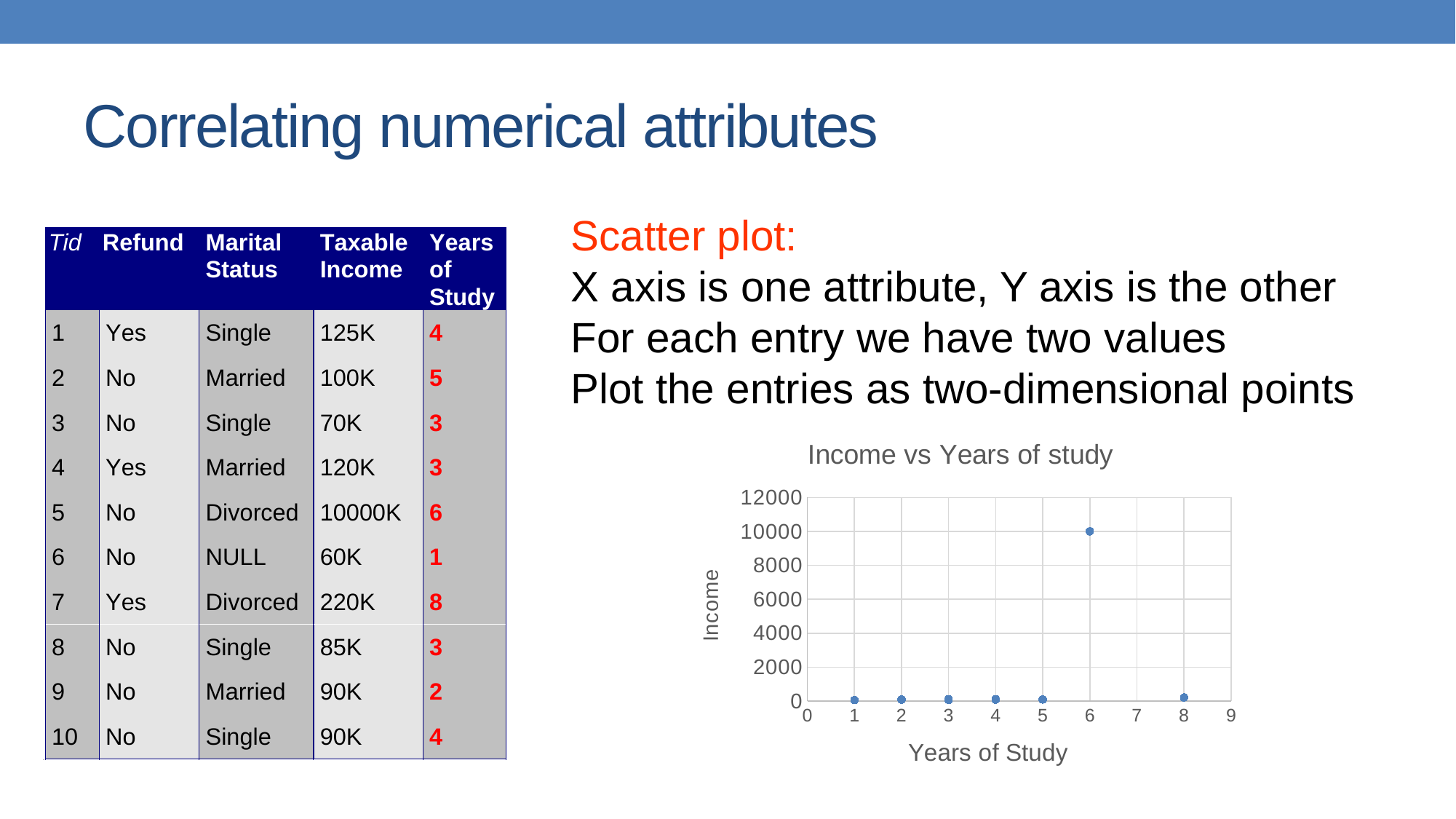
Is the Income value for the point at 1 Year of Study greater or less than 4000? less Which point has the larger Income: the one at 6 Years of Study or the one at 8 Years of Study? 6 Years of Study At which value of Years of Study does the chart show the highest Income? 6 Is the Income value for the point at 8 Years of Study greater or less than 2000? less What is the highest value shown on the y axis of the chart? 12000 Which point has the larger Income: the one at 6 Years of Study or the one at 2 Years of Study? 6 Years of Study Is the Income value for the point at 6 Years of Study greater or less than 8000? greater What is the title of the chart? Income vs Years of study What is the label of the x axis of the chart? Years of Study What kind of chart is shown on the slide? scatter plot